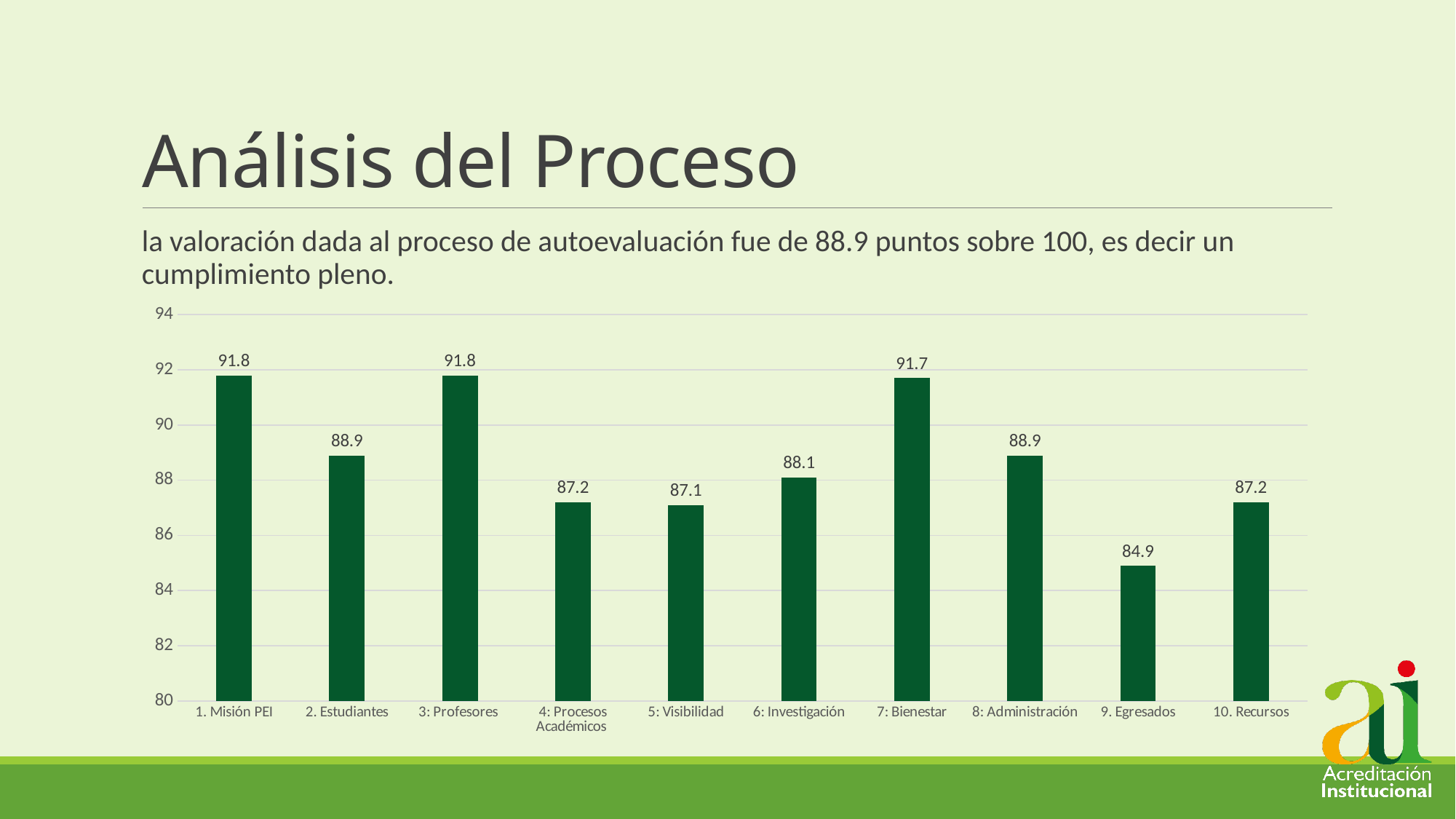
Which is larger, the value for 8: Administración or the value for 10. Recursos? 8: Administración What is the title of the slide containing the chart? Análisis del Proceso Which is larger, the value for 4: Procesos Académicos or the value for 6: Investigación? 6: Investigación What is the value for 7: Bienestar? 91.7 What kind of chart is shown on the slide? bar chart What is the difference between the values for 1. Misión PEI and 9. Egresados? 6.9 What is the value for 6: Investigación? 88.1 How many categories are shown on the x axis? 10 What is the difference between the values for 2. Estudiantes and 5: Visibilidad? 1.8 Is the value for 9. Egresados greater or less than 86? less What is the value for 9. Egresados? 84.9 Which category has the lowest value? 9. Egresados